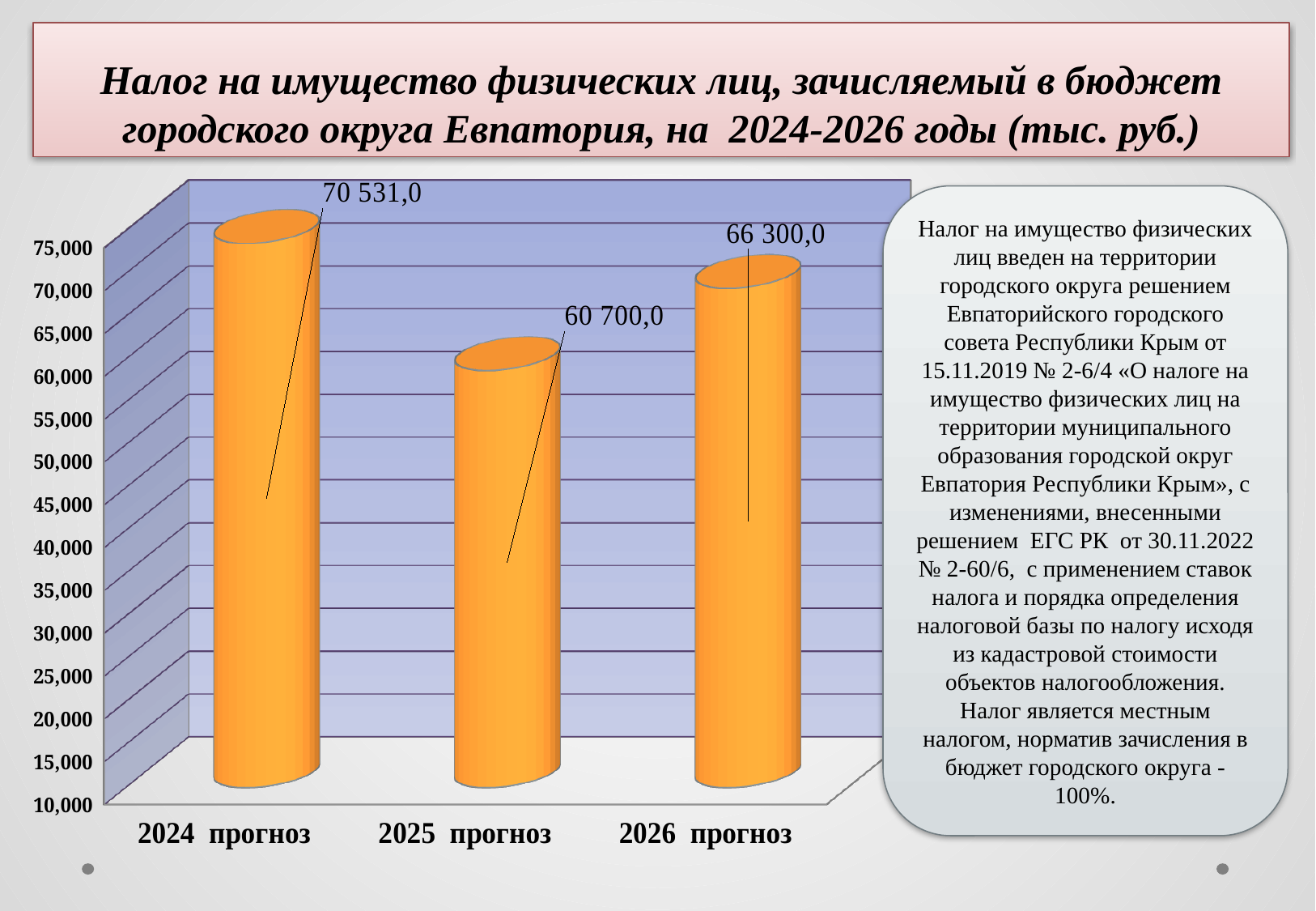
Which is larger, the value for 2026 прогноз or the value for 2025 прогноз? 2026 прогноз How many categories are shown on the x axis? 3 Which year has the lowest value? 2025 прогноз Which year has the highest value? 2024 прогноз What is the difference between the values for 2024 прогноз and 2025 прогноз? 9 831,0 What is the difference between the values for 2026 прогноз and 2025 прогноз? 5 600,0 What is the value for 2026 прогноз? 66 300,0 What is the value for 2024 прогноз? 70 531,0 What is the value for 2025 прогноз? 60 700,0 Does the value rise or fall from 2024 прогноз to 2025 прогноз? fall Is the value for 2025 прогноз greater or less than 65,000? less What kind of chart is shown on the slide? bar chart